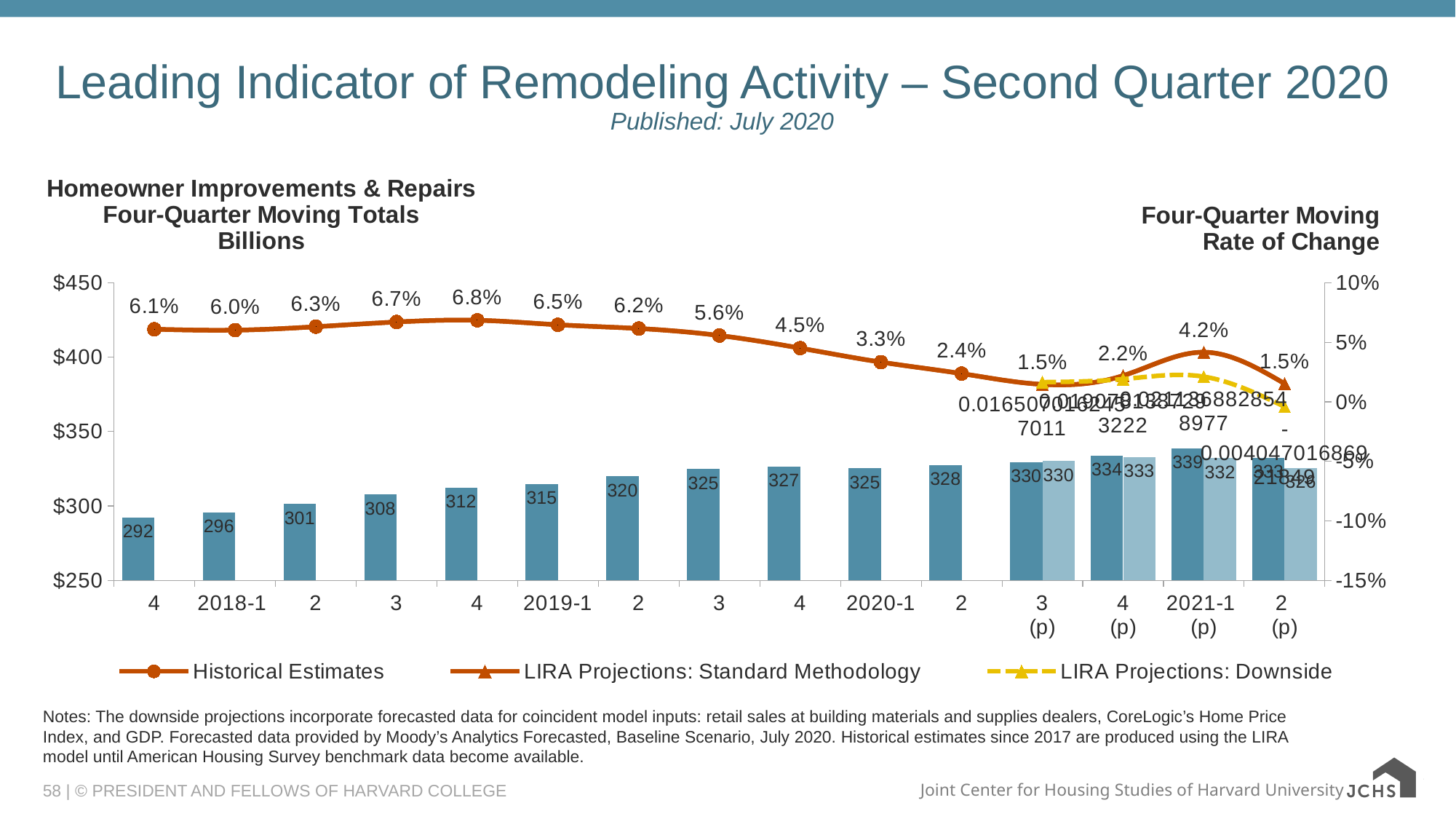
How many quarters are shown on the x axis? 15 Is the four-quarter moving total for 2020-2 greater or less than $350? less What is the four-quarter moving rate of change for 2020-1? 3.3% What is the highest four-quarter moving rate of change shown on the chart? 6.8% Does the four-quarter moving rate of change rise or fall from 2019-1 to 2020-2? fall What kind of chart is this? Combined bar and line chart What is the lowest four-quarter moving total (billions) shown on the chart? 292 How many series does the legend list? 3 What is the LIRA Projections: Standard Methodology rate of change for 2021-1 (p)? 4.2% What is the four-quarter moving total (billions) for 2019-1? 315 What is the difference between the four-quarter moving totals for 2020-1 and 2019-1? 10 Which has the higher four-quarter moving rate of change, 2018-1 or 2019-1? 2019-1